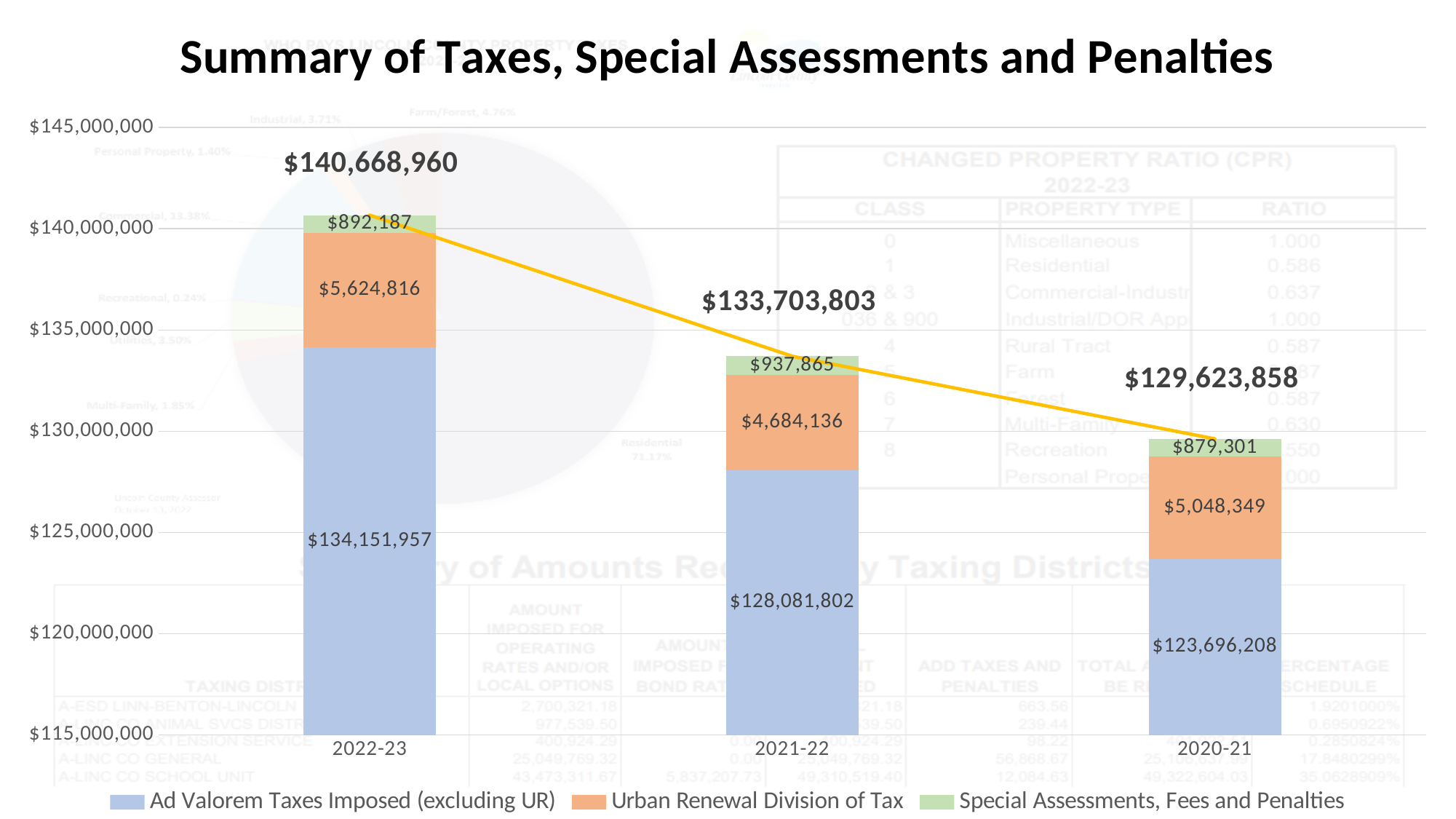
What kind of chart is shown on the slide? Stacked bar chart Which year has the highest total of taxes, special assessments and penalties? 2022-23 What is the difference between the Urban Renewal Division of Tax values for 2022-23 and 2021-22? $940,680 What is the value of Ad Valorem Taxes Imposed (excluding UR) for 2022-23? $134,151,957 How many years are shown on the x axis? 3 Do the bar totals rise or fall from 2022-23 to 2020-21 along the x axis? Fall What is the value of Urban Renewal Division of Tax for 2021-22? $4,684,136 What is the total of the stacked bar for 2021-22? $133,703,803 What is the value of Special Assessments, Fees and Penalties for 2020-21? $879,301 Which is larger, the Special Assessments, Fees and Penalties value for 2021-22 or for 2022-23? 2021-22 How many series does the legend list? 3 Which year has the lowest value for Ad Valorem Taxes Imposed (excluding UR)? 2020-21